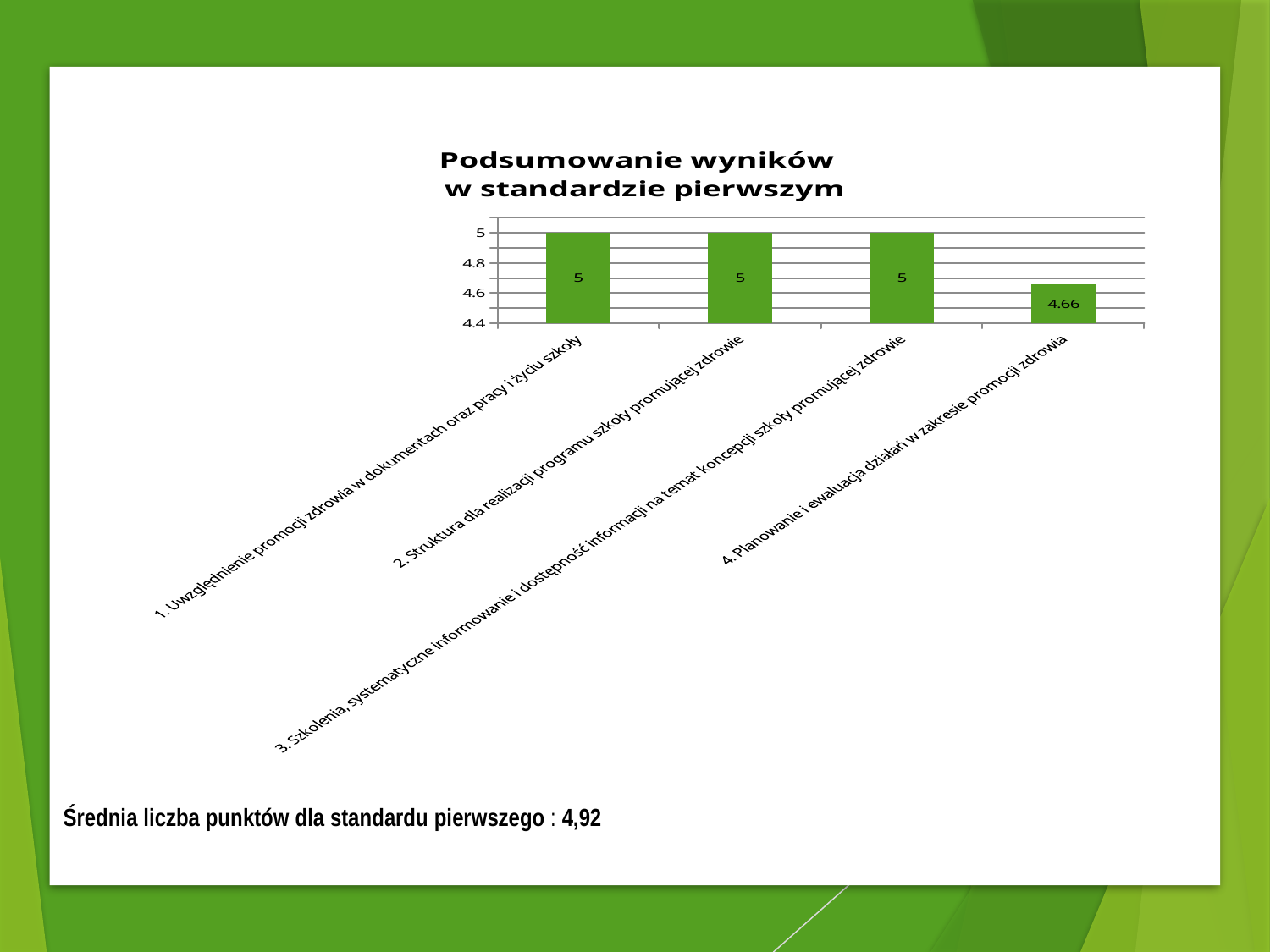
What is the value for category 4, "Planowanie i ewaluacja działań w zakresie promocji zdrowia"? 4.66 Is the value for category 4 greater or less than 4.8? less What is the value for category 1, "Uwzględnienie promocji zdrowia w dokumentach oraz pracy i życiu szkoły"? 5 Which category has the lowest value? 4. Planowanie i ewaluacja działań w zakresie promocji zdrowia What is the difference between the value for category 1 and the value for category 4? 0.34 What is the value for category 2, "Struktura dla realizacji programu szkoły promującej zdrowie"? 5 What is the lowest value shown on the vertical axis? 4.4 How many categories have a value of 5? 3 What kind of chart is shown on the slide? Bar chart What is the title of the chart? Podsumowanie wyników w standardzie pierwszym How many categories are shown in the chart? 4 Which is larger: the value for category 3 or the value for category 4? Category 3 (5)